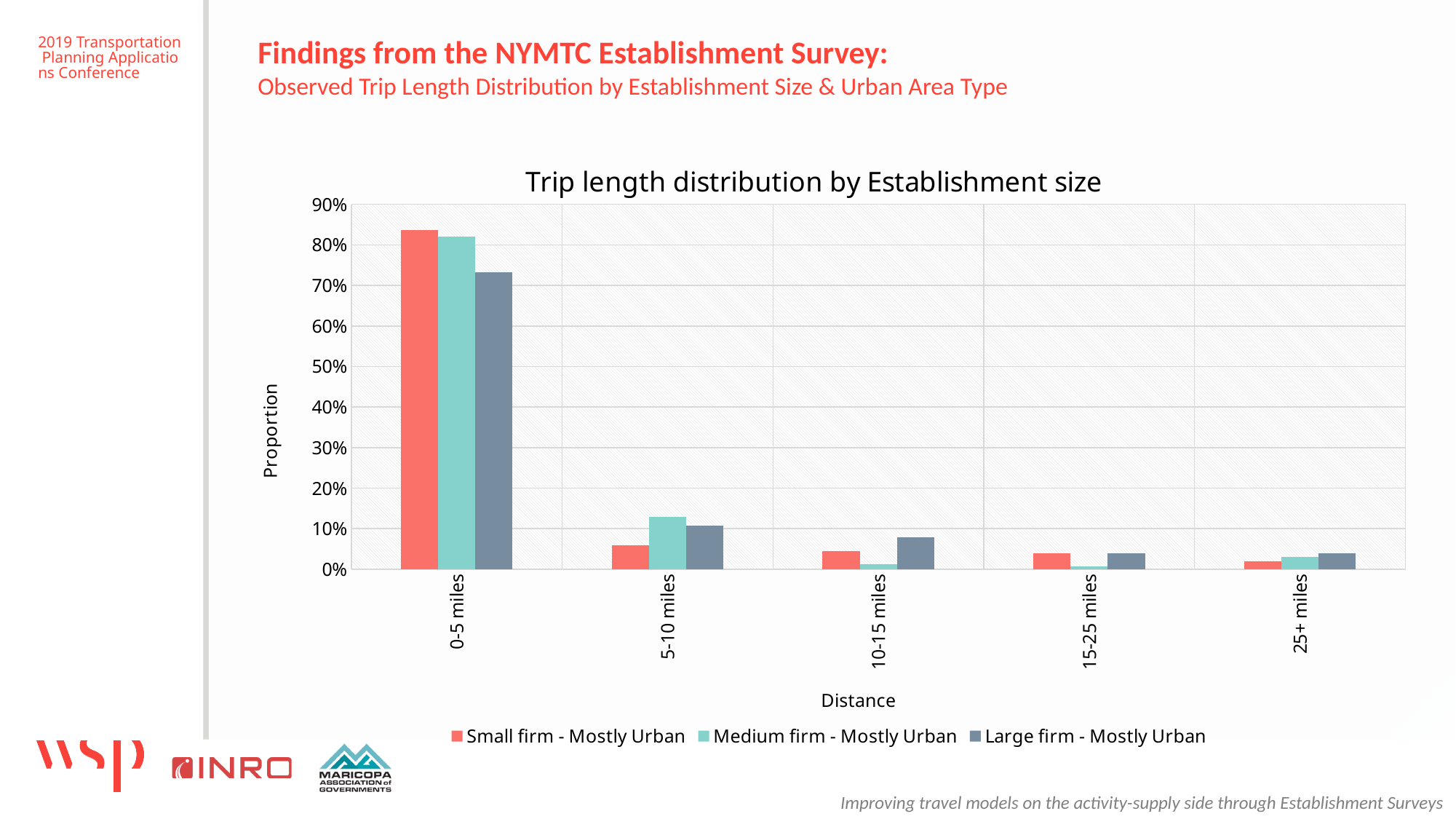
At 10-15 miles, which series has the lowest value? Medium firm - Mostly Urban At 0-5 miles, which is larger: Small firm - Mostly Urban or Large firm - Mostly Urban? Small firm - Mostly Urban How many series does the legend list? 3 Which distance category has the highest value for Large firm - Mostly Urban? 0-5 miles What kind of chart is shown on the slide? Bar chart How many distance categories are shown on the x axis? 5 Is the value for Small firm - Mostly Urban at 0-5 miles greater or less than 80%? greater What is the title of the chart? Trip length distribution by Establishment size Do the values for Small firm - Mostly Urban rise or fall as distance increases along the x axis? fall Is the value for Large firm - Mostly Urban at 0-5 miles greater or less than 80%? less Is the value for Medium firm - Mostly Urban at 5-10 miles greater or less than 10%? greater At 5-10 miles, which is larger: Small firm - Mostly Urban or Medium firm - Mostly Urban? Medium firm - Mostly Urban